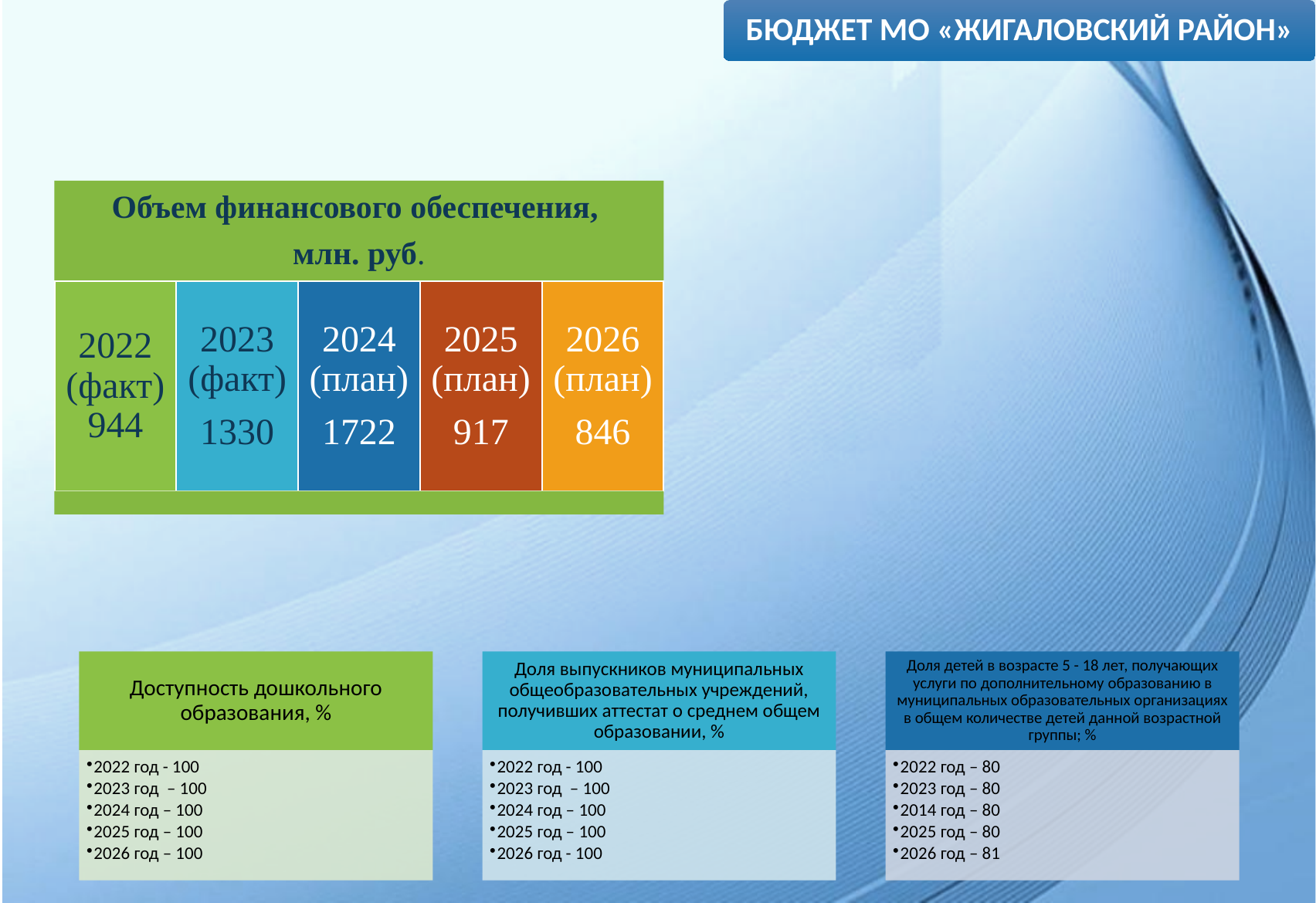
What unit is stated in the title of the 'Объем финансового обеспечения' graphic? млн. руб. In the 'Объем финансового обеспечения, млн. руб.' graphic, which is larger: the value for 2025 (план) or 2026 (план)? 2025 (план) How many years are shown in the 'Объем финансового обеспечения, млн. руб.' graphic? 5 In the 'Объем финансового обеспечения, млн. руб.' graphic, do the values rise or fall from 2024 (план) to 2026 (план)? fall What is the value for 2026 (план) in the 'Объем финансового обеспечения, млн. руб.' graphic? 846 What is the value for 2022 (факт) in the 'Объем финансового обеспечения, млн. руб.' graphic? 944 What is the value for 2023 (факт) in the 'Объем финансового обеспечения, млн. руб.' graphic? 1330 What is the value for 2024 (план) in the 'Объем финансового обеспечения, млн. руб.' graphic? 1722 Which year has the lowest value in the 'Объем финансового обеспечения, млн. руб.' graphic? 2026 (план) What is the difference between the values for 2023 (факт) and 2022 (факт) in the 'Объем финансового обеспечения, млн. руб.' graphic? 386 What is the difference between the values for 2024 (план) and 2025 (план) in the 'Объем финансового обеспечения, млн. руб.' graphic? 805 Which year has the highest value in the 'Объем финансового обеспечения, млн. руб.' graphic? 2024 (план)